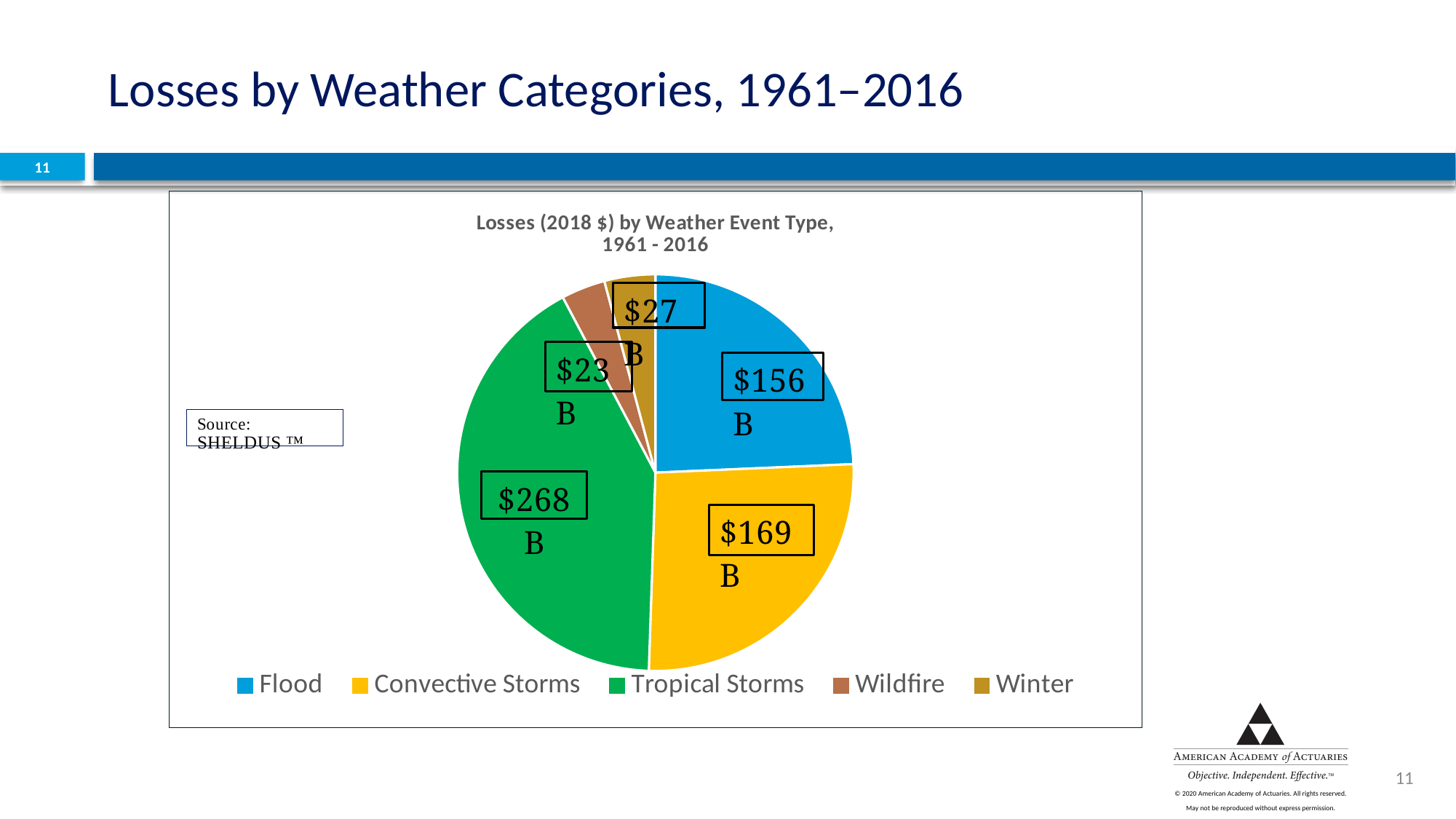
Which weather event type has the smallest losses? Wildfire What is the difference in losses between Convective Storms and Flood? $13 B Which has larger losses, Winter or Wildfire? Winter What is the loss value for Flood? $156 B What is the loss value for Winter? $27 B What type of chart is shown on the slide? Pie chart What is the loss value for Convective Storms? $169 B What is the title of the chart? Losses (2018 $) by Weather Event Type, 1961 - 2016 How many weather event types are shown in the pie chart? 5 What is the difference in losses between Tropical Storms and Flood? $112 B Which weather event type has the largest losses? Tropical Storms What is the loss value for Tropical Storms? $268 B